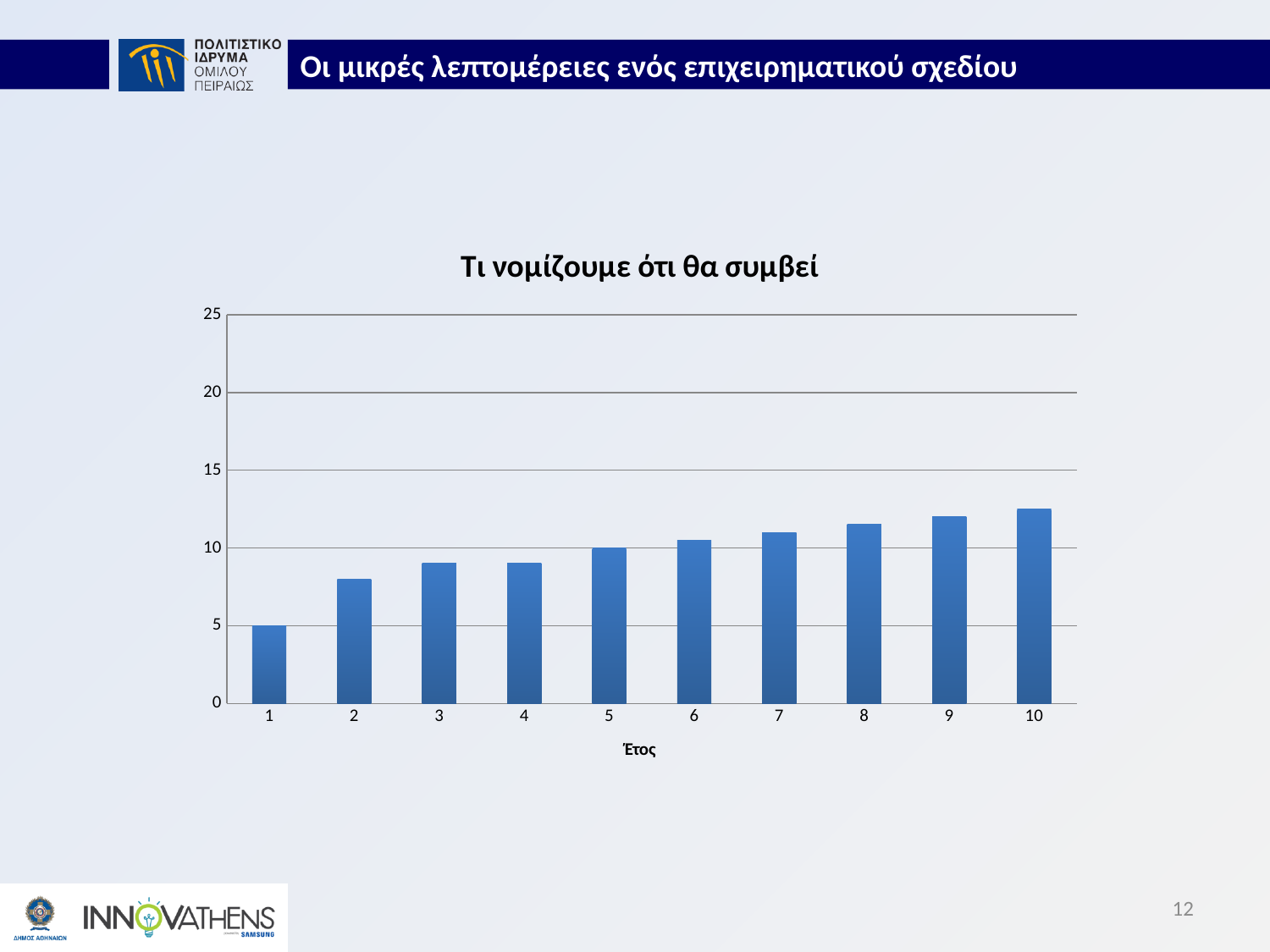
Do the values generally rise or fall from year 1 to year 10? rise What is the difference between the values for year 5 and year 1? 5 What is the value for year 5? 10 How many bars (years) are plotted in the chart? 10 Is the value for year 10 greater or less than 10? greater What type of chart is shown on the slide? bar chart Which year has the highest value? 10 What is the label of the x axis? Έτος What is the value for year 1? 5 Which year has the lowest value? 1 What is the title of the chart? Τι νομίζουμε ότι θα συμβεί Is the value for year 2 greater or less than 10? less